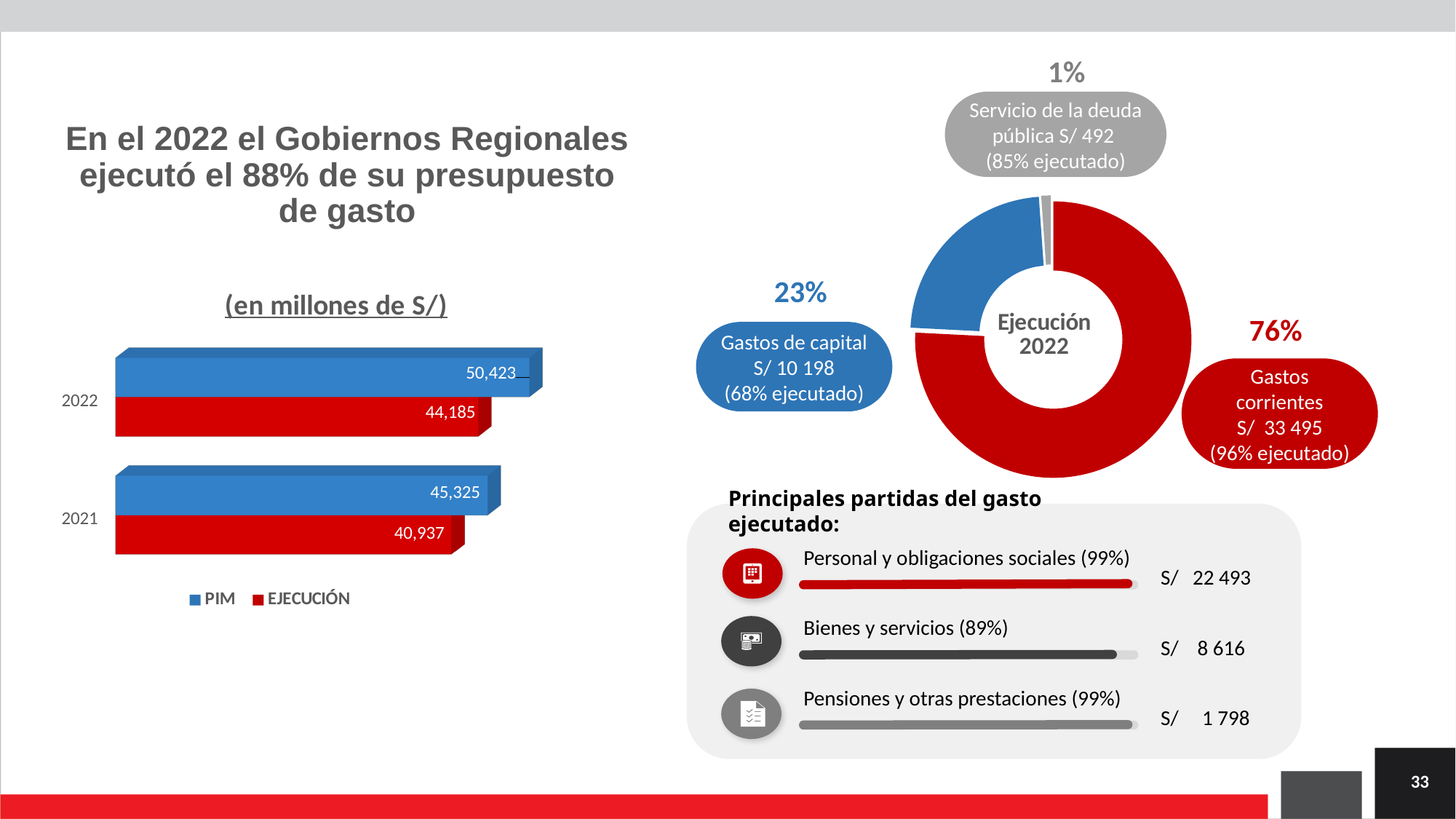
What kind of chart is the chart on the left of the slide? Bar chart In the bar chart on the left, does the PIM value rise or fall from 2021 to 2022? Rise In the donut chart titled 'Ejecución 2022', how many categories are shown? 3 In the bar chart on the left, what is the PIM value for 2022? 50,423 In the bar chart on the left, which colour represents EJECUCIÓN? Red In the bar chart on the left, which year has the higher EJECUCIÓN value? 2022 In the donut chart titled 'Ejecución 2022', what is the amount shown for Gastos de capital? S/ 10 198 In the donut chart titled 'Ejecución 2022', which category has the smallest share? Servicio de la deuda pública In the bar chart on the left, what is the EJECUCIÓN value for 2021? 40,937 In the bar chart on the left, what is the difference between PIM and EJECUCIÓN for 2022? 6,238 In the bar chart on the left, how many series does the legend list? 2 In the donut chart titled 'Ejecución 2022', what share does Gastos corrientes represent? 76%